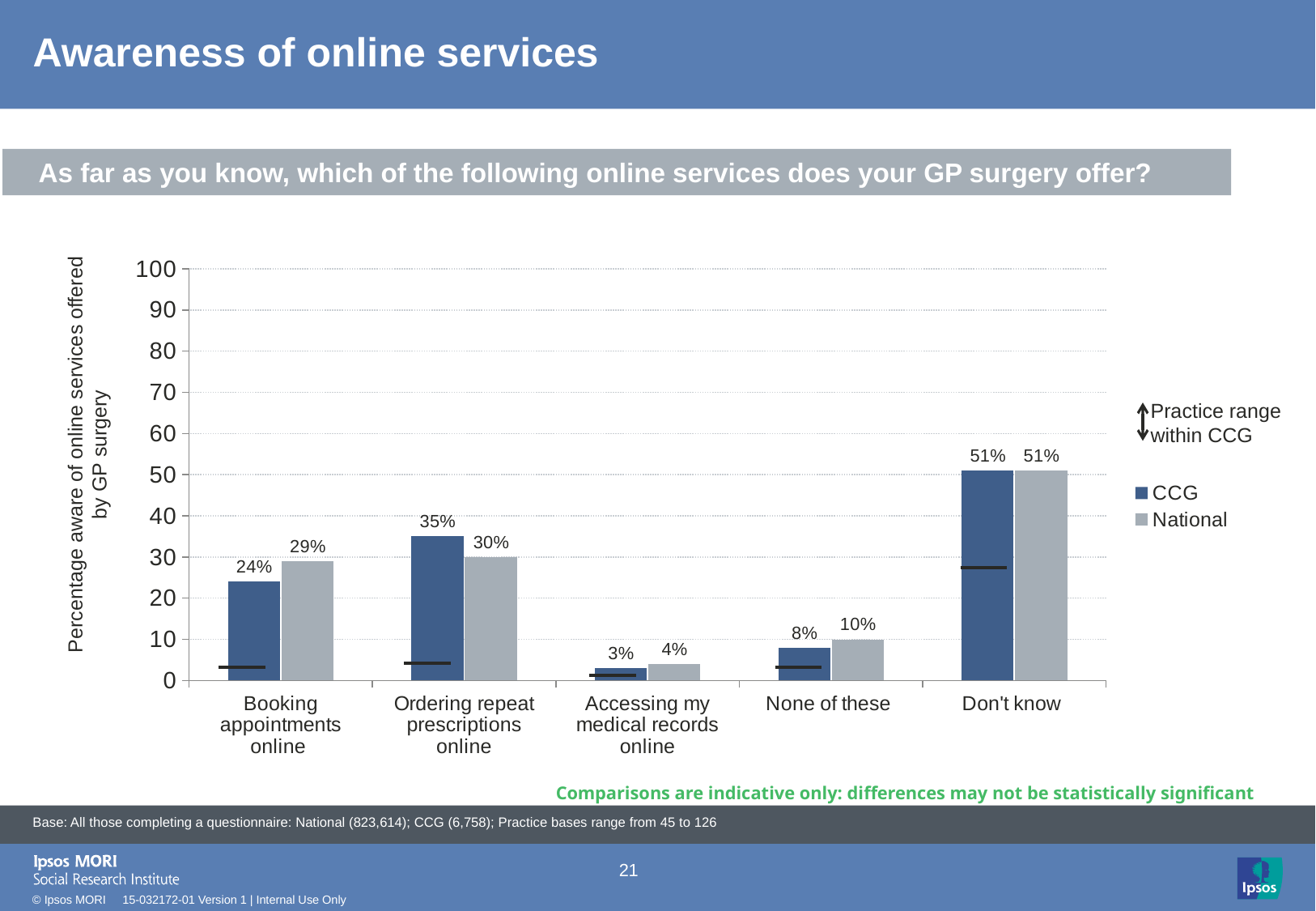
What is the National value for Ordering repeat prescriptions online? 30% What does the arrow symbol in the legend represent? Practice range within CCG Which category has the highest CCG value? Don't know What is the CCG value for Booking appointments online? 24% How many categories are shown on the x axis? 5 What is the National value for None of these? 10% For Booking appointments online, which is larger, the CCG value or the National value? National What kind of chart is shown on the slide? Bar chart How many series does the legend list as bars? 2 Which category has the lowest National value? Accessing my medical records online What is the difference between the CCG and National values for Ordering repeat prescriptions online? 5% What is the CCG value for Accessing my medical records online? 3%